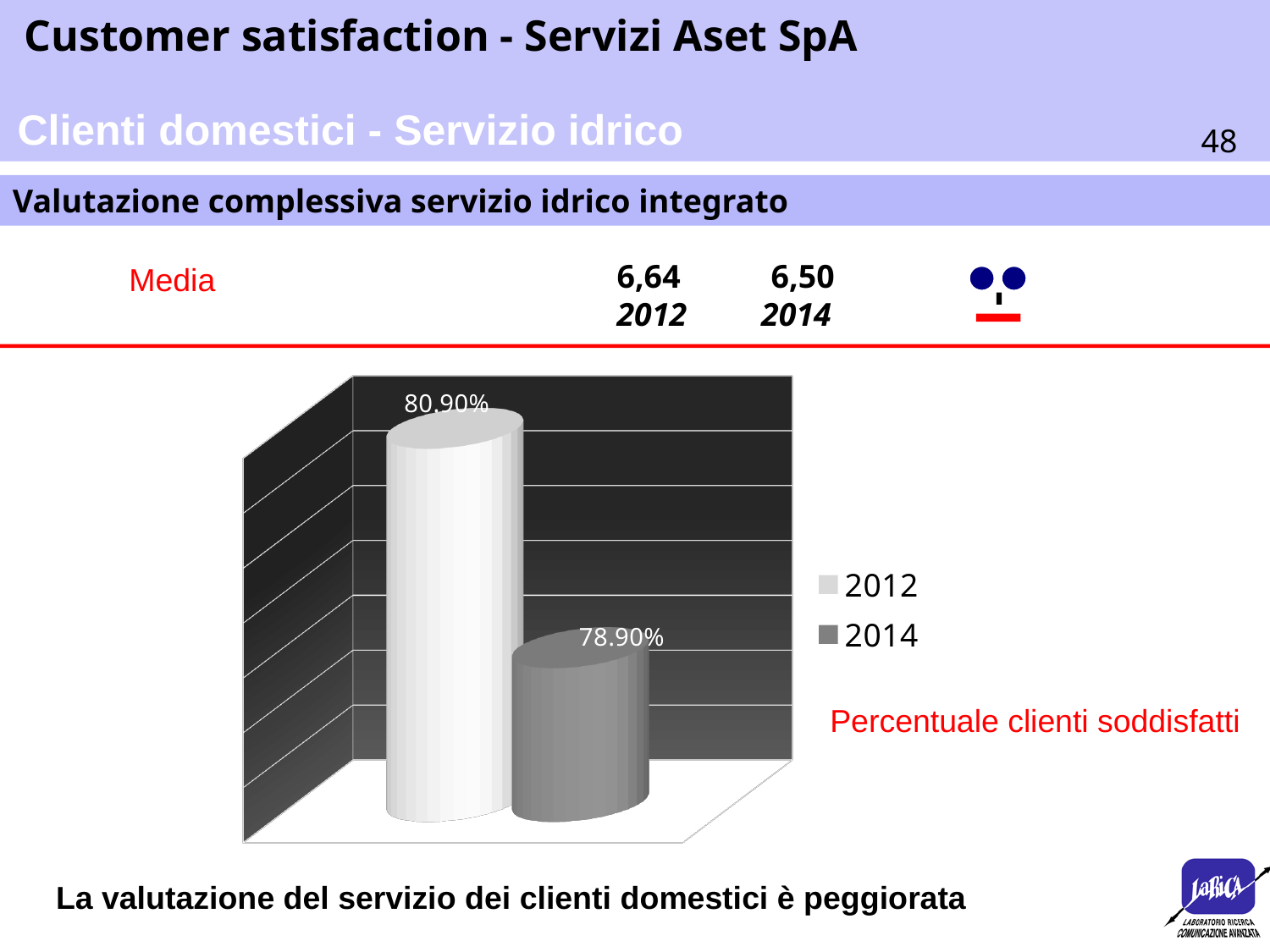
Is the value for 2012 larger or smaller than the value for 2014? larger What is the value shown for 2014 in the chart? 78,90% What are the two entries listed in the chart legend? 2012 and 2014 Which year has the lower percentage of satisfied customers in the chart? 2014 How many series does the chart legend list? 2 How many bars are plotted in the chart? 2 Which year has the higher percentage of satisfied customers in the chart? 2012 By how many percentage points does the 2012 value exceed the 2014 value in the chart? 2,00% What does the red label next to the chart say the plotted values represent? Percentuale clienti soddisfatti What is the value shown for 2012 in the chart? 80,90% Does the percentage of satisfied customers rise or fall from 2012 to 2014? fall What kind of chart is shown on the slide? bar chart